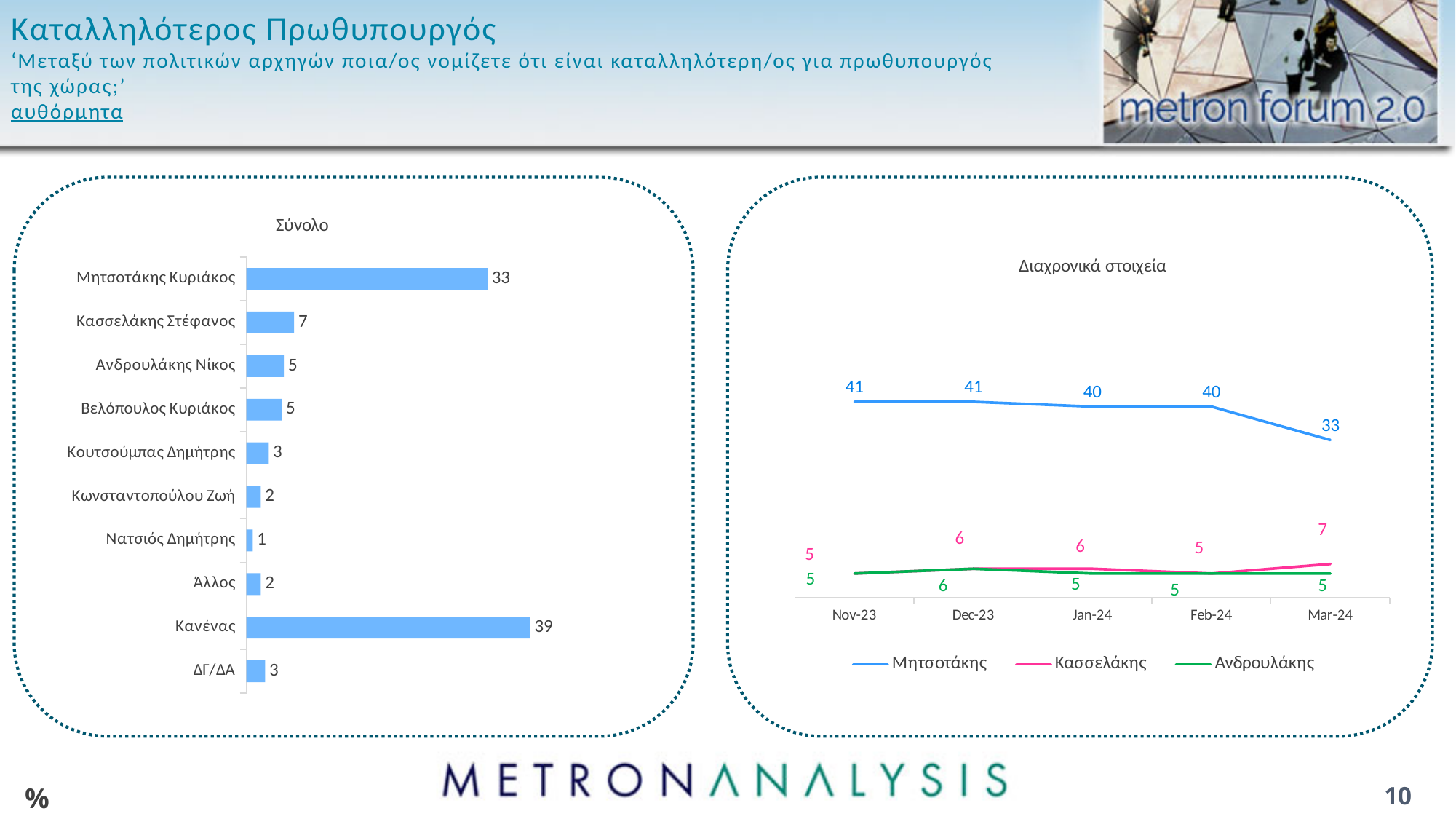
In the 'Σύνολο' bar chart, what is the difference between the values for Κανένας and Μητσοτάκης Κυριάκος? 6 In the 'Διαχρονικά στοιχεία' line chart, which series is shown in green? Ανδρουλάκης In the 'Διαχρονικά στοιχεία' line chart, how many series does the legend list? 3 In the 'Σύνολο' bar chart, how many categories are shown? 10 In the 'Διαχρονικά στοιχεία' line chart, what is the value for Μητσοτάκης in Mar-24? 33 In the 'Διαχρονικά στοιχεία' line chart, what is the difference between the Μητσοτάκης values for Feb-24 and Mar-24? 7 In the 'Σύνολο' bar chart, what is the value for Μητσοτάκης Κυριάκος? 33 In the 'Διαχρονικά στοιχεία' line chart, what is the value for Κασσελάκης in Dec-23? 6 In the 'Διαχρονικά στοιχεία' line chart, does the Μητσοτάκης line rise or fall from Nov-23 to Mar-24? Fall What kind of chart is the 'Σύνολο' chart on the left? Bar chart In the 'Σύνολο' bar chart, which category has the highest value? Κανένας In the 'Σύνολο' bar chart, which category has the lowest value? Νατσιός Δημήτρης